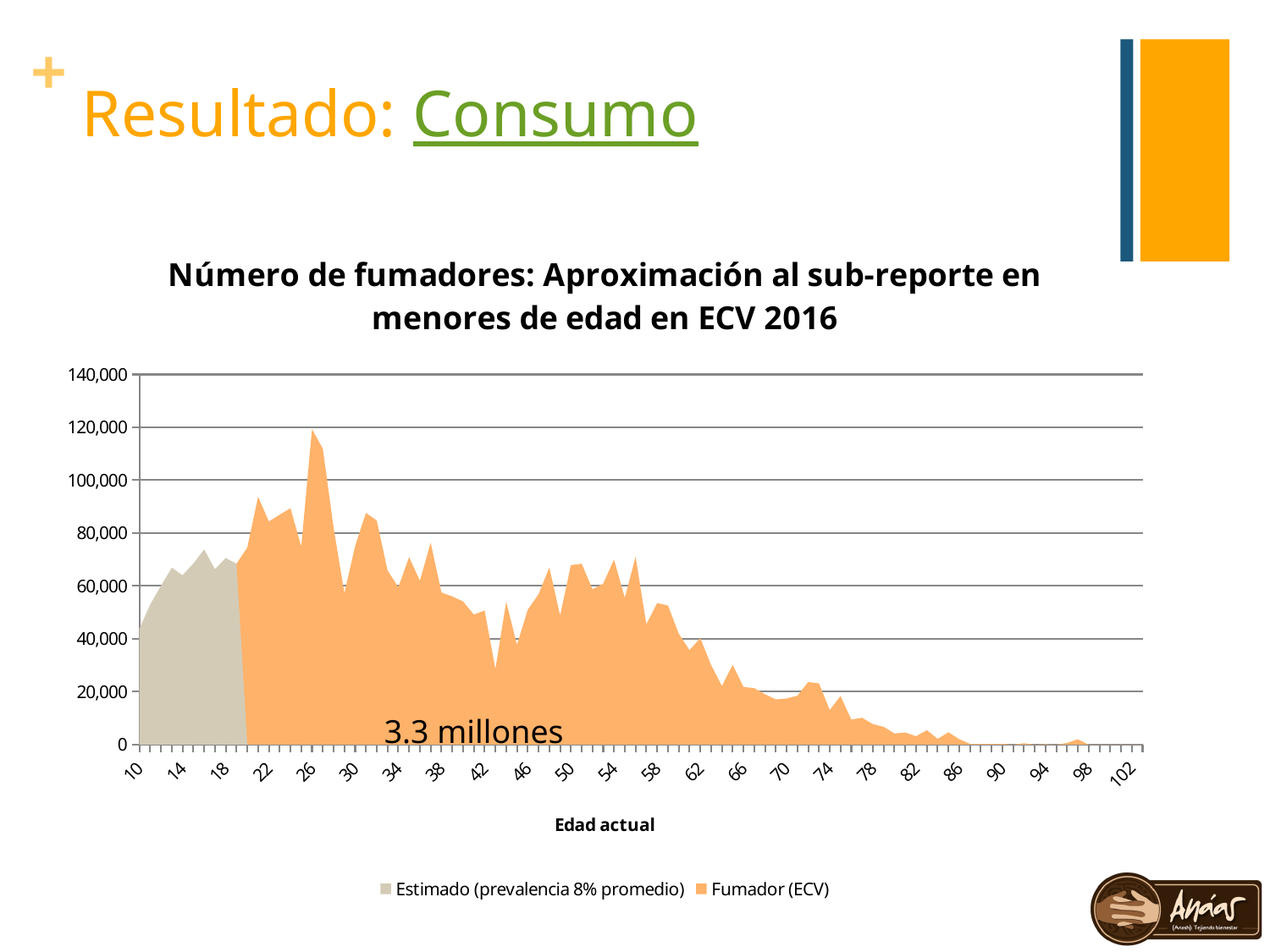
Is the value for Fumador (ECV) at age 86 greater or less than 20,000? less What kind of chart is shown on the slide? area chart What is the title of the chart? Número de fumadores: Aproximación al sub-reporte en menores de edad en ECV 2016 How many series does the legend list? 2 Is the value at age 10 greater or less than 60,000? less Which series is plotted for ages below 20? Estimado (prevalencia 8% promedio) What is the highest value shown on the y axis? 140,000 Is the value at age 14 greater or less than 40,000? greater Do the Fumador (ECV) values generally rise or fall from age 30 to age 102? fall What is the label of the x axis? Edad actual